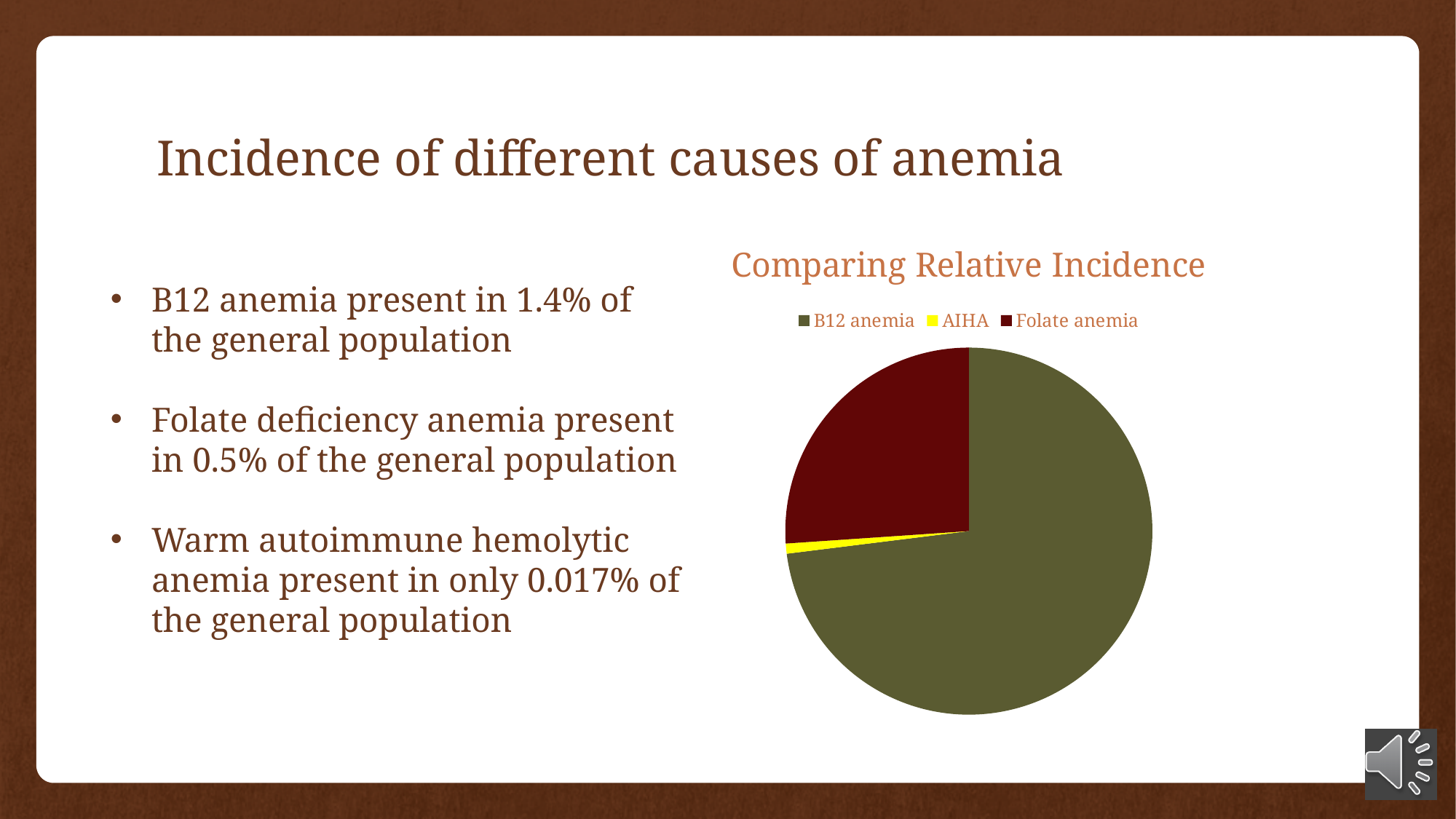
What kind of chart is shown on the slide? pie chart Which slice is larger, B12 anemia or Folate anemia? B12 anemia How many entries does the chart legend list? 3 Which category has the smallest slice of the pie? AIHA Which category has the largest slice of the pie? B12 anemia What is the title of the chart? Comparing Relative Incidence Which category is shown in yellow in the pie chart? AIHA Does the B12 anemia slice take up more or less than half of the pie? more Which slice is larger, Folate anemia or AIHA? Folate anemia How many slices does the pie chart have? 3